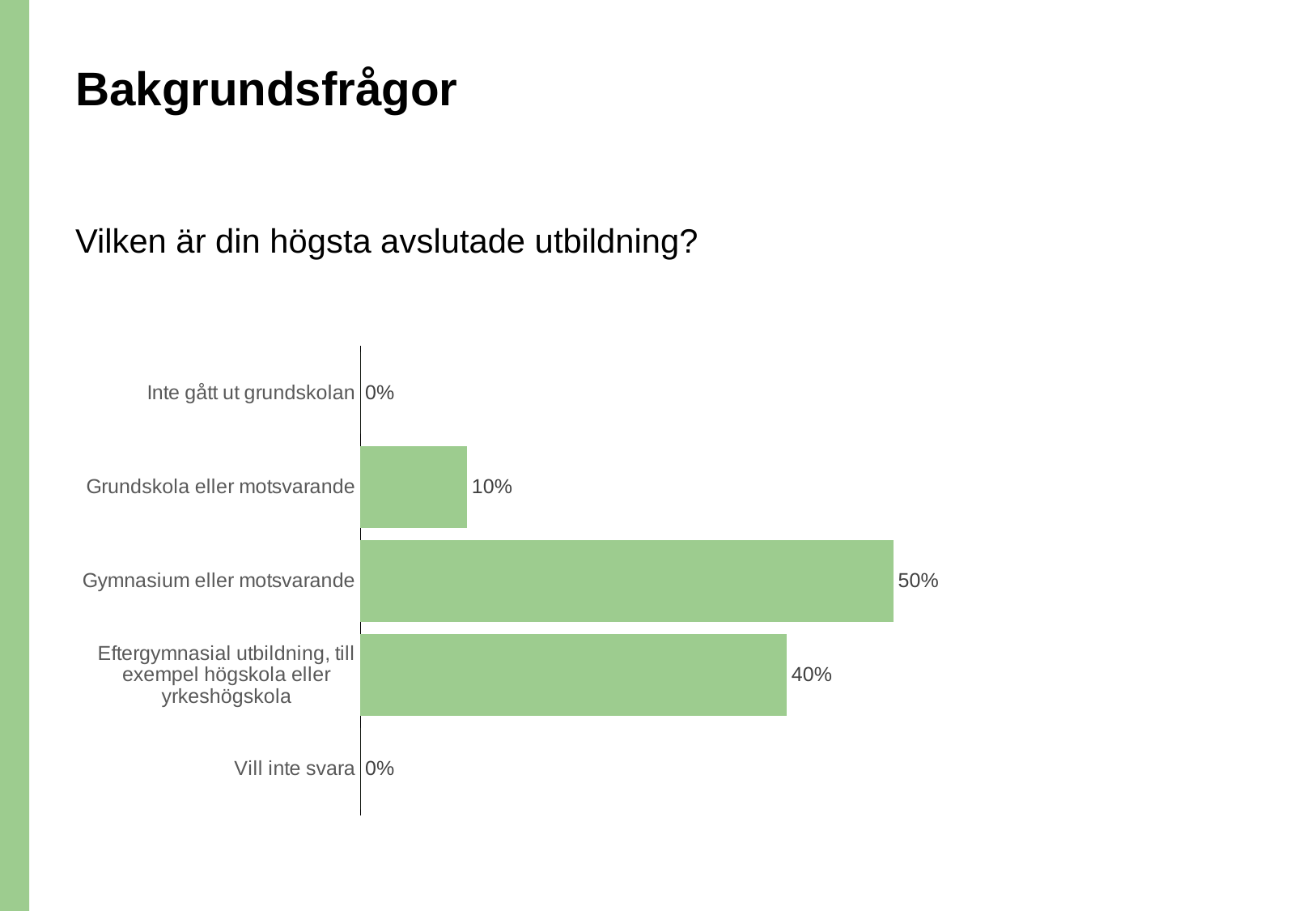
Which is larger, the value for Grundskola eller motsvarande or the value for Eftergymnasial utbildning? Eftergymnasial utbildning Which category has the highest value? Gymnasium eller motsvarande How many categories have a value of 0%? 2 What is the value for Gymnasium eller motsvarande? 50% How many categories are shown in the chart? 5 What is the value for Vill inte svara? 0% What is the value for Grundskola eller motsvarande? 10% What is the difference between the values for Eftergymnasial utbildning and Grundskola eller motsvarande? 30% What is the value for Eftergymnasial utbildning, till exempel högskola eller yrkeshögskola? 40% What kind of chart is shown on the slide? Bar chart What is the difference between the values for Gymnasium eller motsvarande and Eftergymnasial utbildning? 10% What question does the chart present results for? Vilken är din högsta avslutade utbildning?